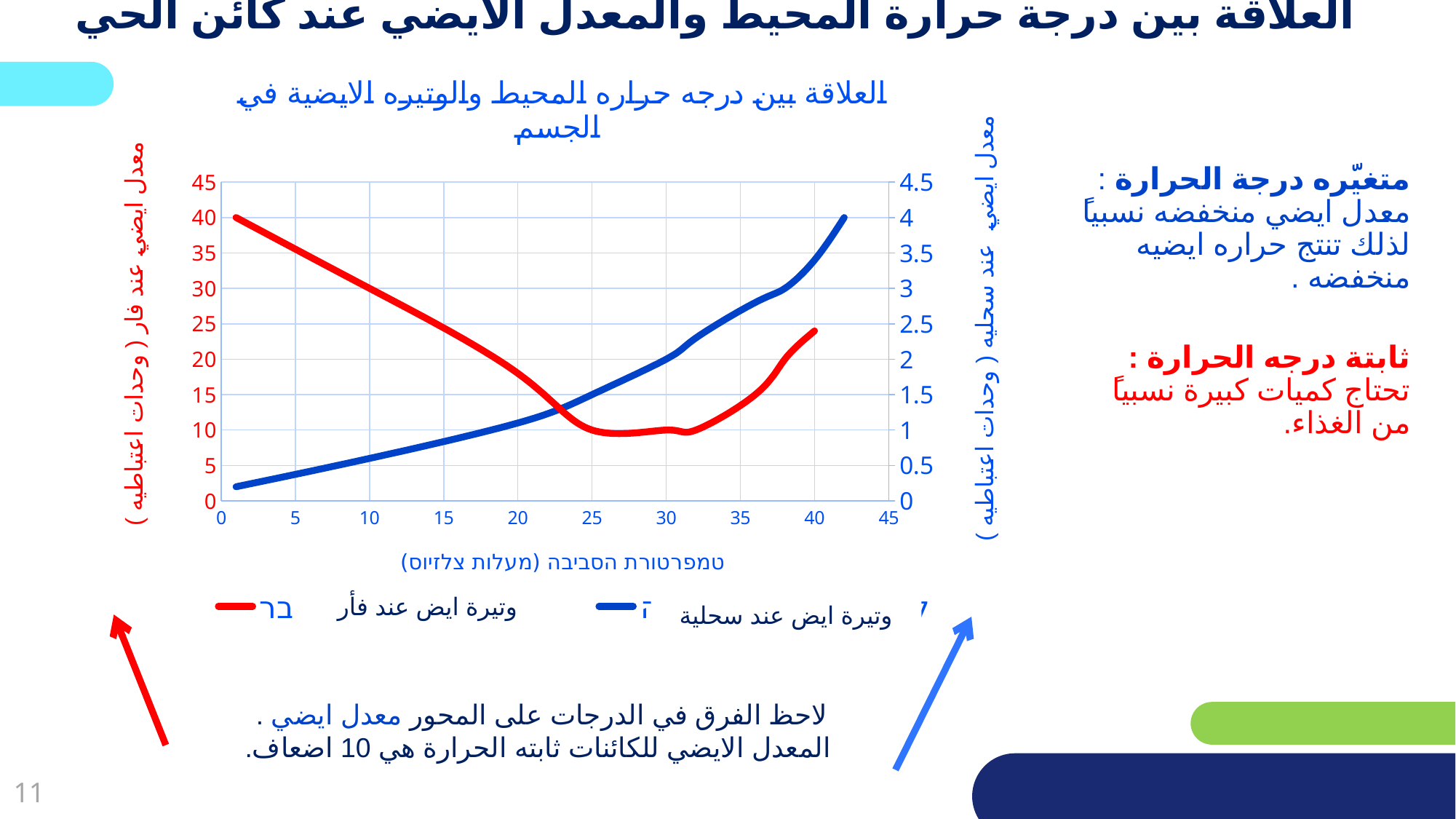
Is the value of the blue line (وتيرة ايض عند سحلية) at temperature 10 greater or less than 1 on the right axis? less Is the value of the red line (وتيرة ايض عند فأر) at temperature 35 greater or less than 20 on the left axis? less Does the blue line (وتيرة ايض عند سحلية) rise or fall as temperature increases along the x axis? rise Is the value of the blue line (وتيرة ايض عند سحلية) at temperature 40 greater or less than 3 on the right axis? greater What is the maximum value shown on the right-hand vertical axis of the chart? 4.5 Which colour is the line for وتيرة ايض عند سحلية (lizard metabolic rate)? blue Which colour is the line for وتيرة ايض عند فأر (rat metabolic rate)? red How many series does the chart's legend list? 2 Does the red line (وتيرة ايض عند فأر) rise or fall between temperatures 0 and 25 on the x axis? fall What kind of chart is shown on the slide? line chart